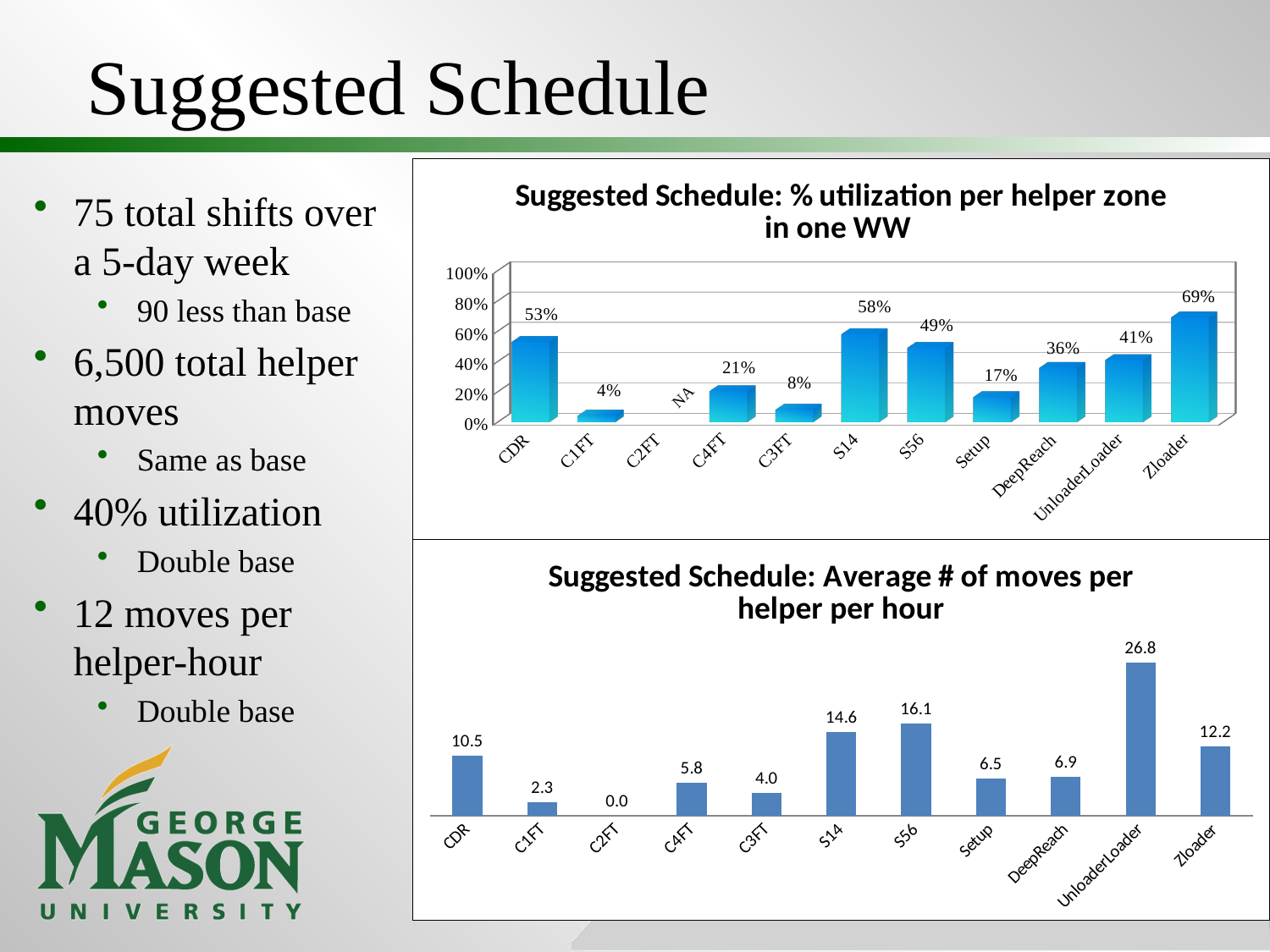
In the top chart (% utilization per helper zone), which helper zone has the highest utilization? Zloader In the top chart (% utilization per helper zone), how many helper zones are shown on the x axis? 11 What is the title of the top chart? Suggested Schedule: % utilization per helper zone in one WW What type of chart is the bottom chart (Average # of moves per helper per hour)? Bar chart In the top chart (% utilization per helper zone), what label is shown for C2FT? NA In the top chart (% utilization per helper zone), which has higher utilization, DeepReach or UnloaderLoader? UnloaderLoader In the bottom chart (Average # of moves per helper per hour), what is the value for UnloaderLoader? 26.8 In the top chart (% utilization per helper zone), what is the difference between the utilization of Zloader and CDR? 16% In the bottom chart (Average # of moves per helper per hour), what is the difference between S56 and S14? 1.5 In the top chart (% utilization per helper zone), what is the utilization for S14? 58% In the bottom chart (Average # of moves per helper per hour), which is larger, Setup or DeepReach? DeepReach In the bottom chart (Average # of moves per helper per hour), which helper zone has the lowest value? C2FT